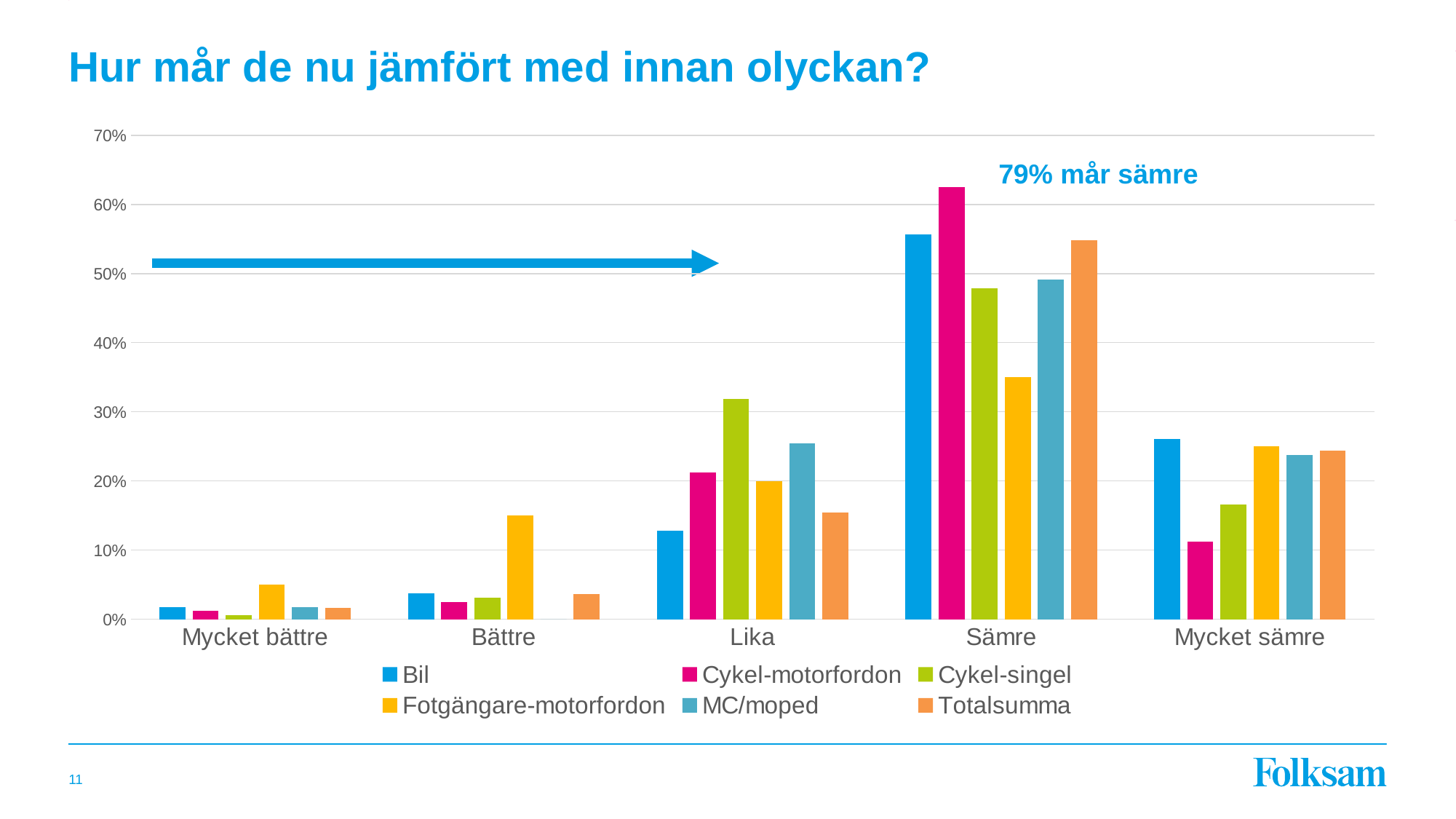
Is the value for Fotgängare-motorfordon in the Sämre category greater or less than 40%? less What kind of chart is shown on the slide? Bar chart Is the value for Cykel-motorfordon in the Sämre category greater or less than 60%? greater What text annotation is shown above the Sämre bars? 79% mår sämre Is the value for Cykel-singel in the Lika category greater or less than 30%? greater In which category is the Totalsumma bar the highest? Sämre In the Mycket sämre category, which series has the lowest bar? Cykel-motorfordon In the Sämre category, which series has the highest bar? Cykel-motorfordon How many categories are shown on the x axis? 5 What is the title of the slide? Hur mår de nu jämfört med innan olyckan? In the Lika category, which is larger: the Cykel-singel bar or the Bil bar? Cykel-singel How many series does the legend list? 6